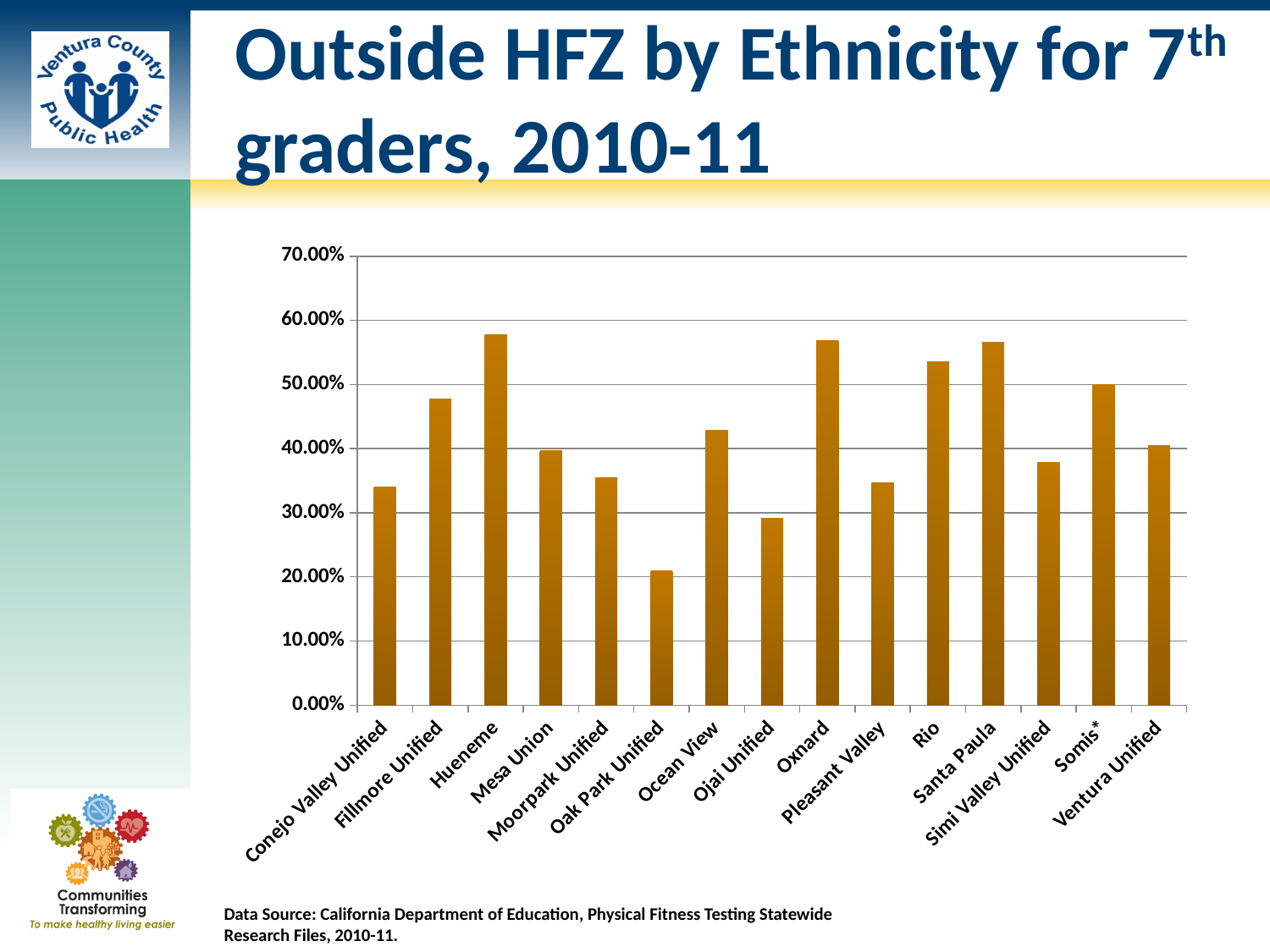
Which is larger, the value for Somis* or the value for Ventura Unified? Somis* Is the value for Conejo Valley Unified greater or less than 40.00%? less Which is larger, the value for Rio or the value for Pleasant Valley? Rio What kind of chart is shown on the slide? bar chart What is the title of the chart on the slide? Outside HFZ by Ethnicity for 7th graders, 2010-11 Is the value for Oak Park Unified greater or less than 30.00%? less Which district has the lowest percentage outside the HFZ? Oak Park Unified Is the value for Hueneme greater or less than 50.00%? greater How many school districts are shown on the x axis of the chart? 15 Which is larger, the value for Fillmore Unified or the value for Mesa Union? Fillmore Unified